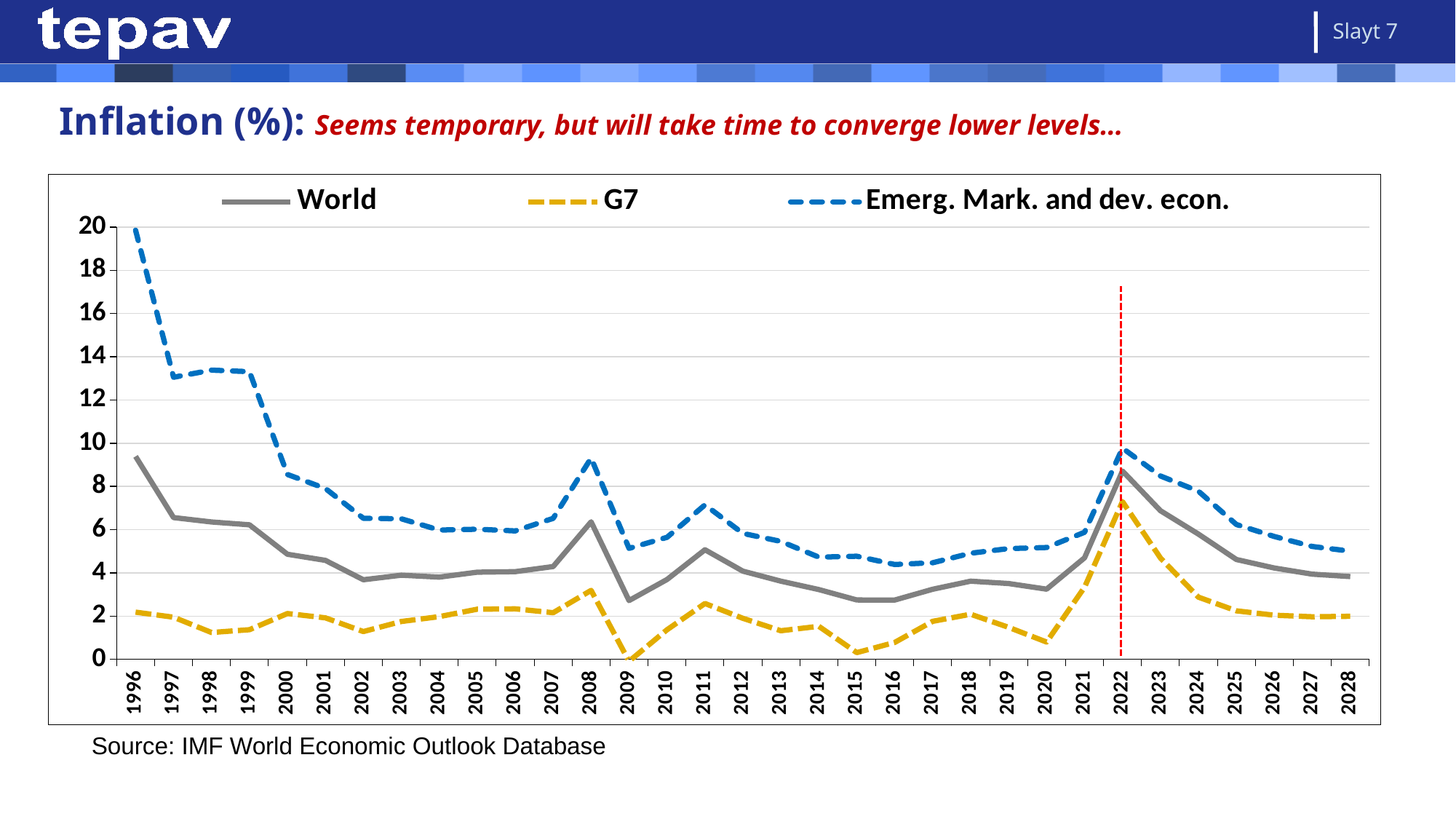
How many series does the legend list? 3 Is the value for World in 2009 greater or less than 4? less Is the value for Emerg. Mark. and dev. econ. in 1996 greater or less than 18? greater Does the Emerg. Mark. and dev. econ. series rise or fall from 1996 to 2002? fall In 2022, which series has the higher value, World or G7? World How many years are shown on the x axis? 33 What kind of chart is shown on the slide? line chart Is the value for Emerg. Mark. and dev. econ. in 2008 greater or less than 8? greater In which year does the Emerg. Mark. and dev. econ. series reach its highest value? 1996 What is the source cited below the chart? IMF World Economic Outlook Database In which year does the G7 series reach its lowest value? 2009